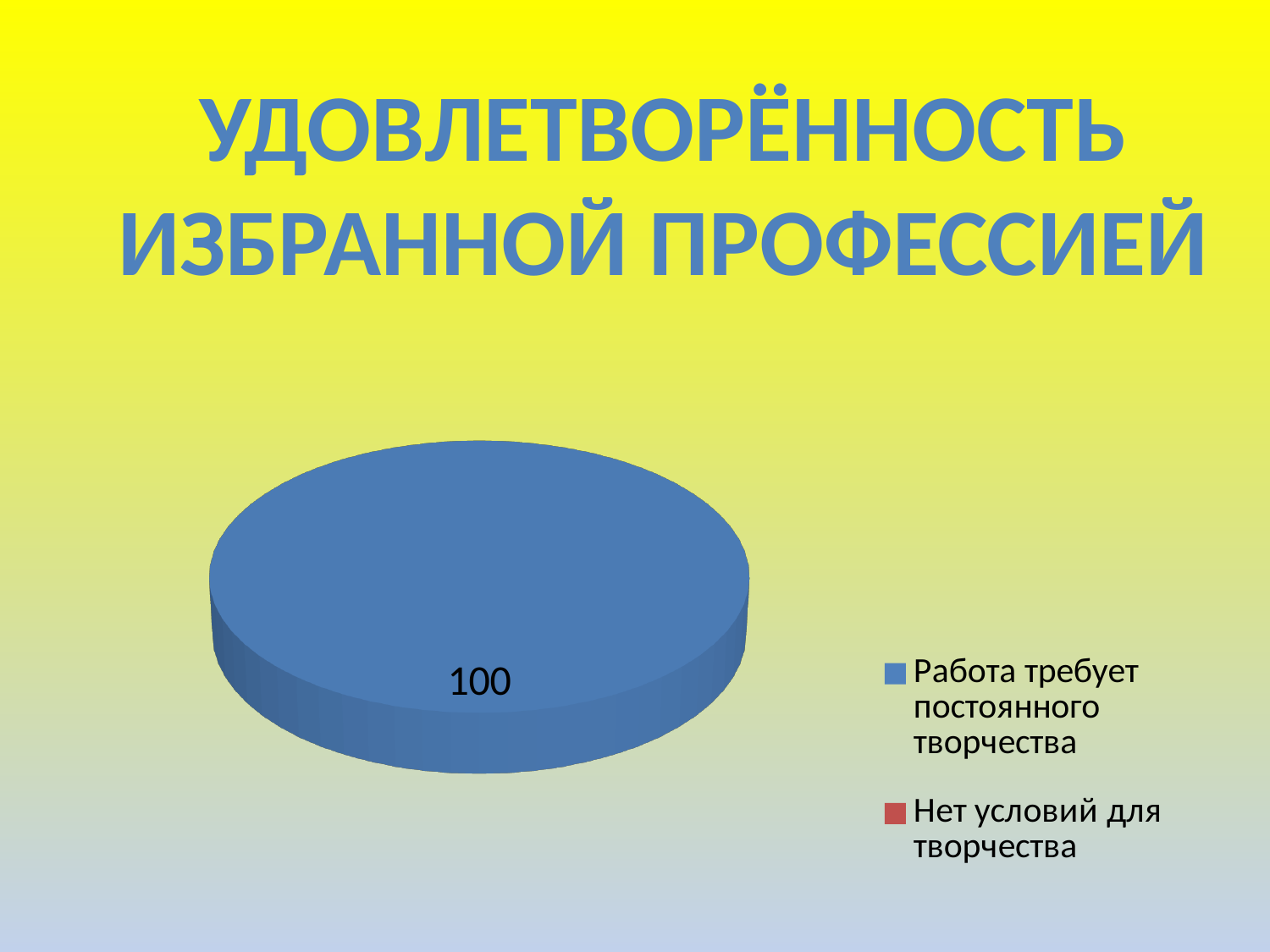
What share of the pie does the "Работа требует постоянного творчества" slice take up? 100% What kind of chart is shown on the slide? pie chart What value is printed on the pie slice for "Работа требует постоянного творчества"? 100 What is the title shown above the chart? УДОВЛЕТВОРЁННОСТЬ ИЗБРАННОЙ ПРОФЕССИЕЙ Which category has the largest slice of the pie? Работа требует постоянного творчества How many entries does the chart legend list? 2 Which is larger: the slice for "Работа требует постоянного творчества" or the slice for "Нет условий для творчества"? Работа требует постоянного творчества What colour is the legend marker for "Нет условий для творчества"? red Which category has the smallest slice of the pie? Нет условий для творчества